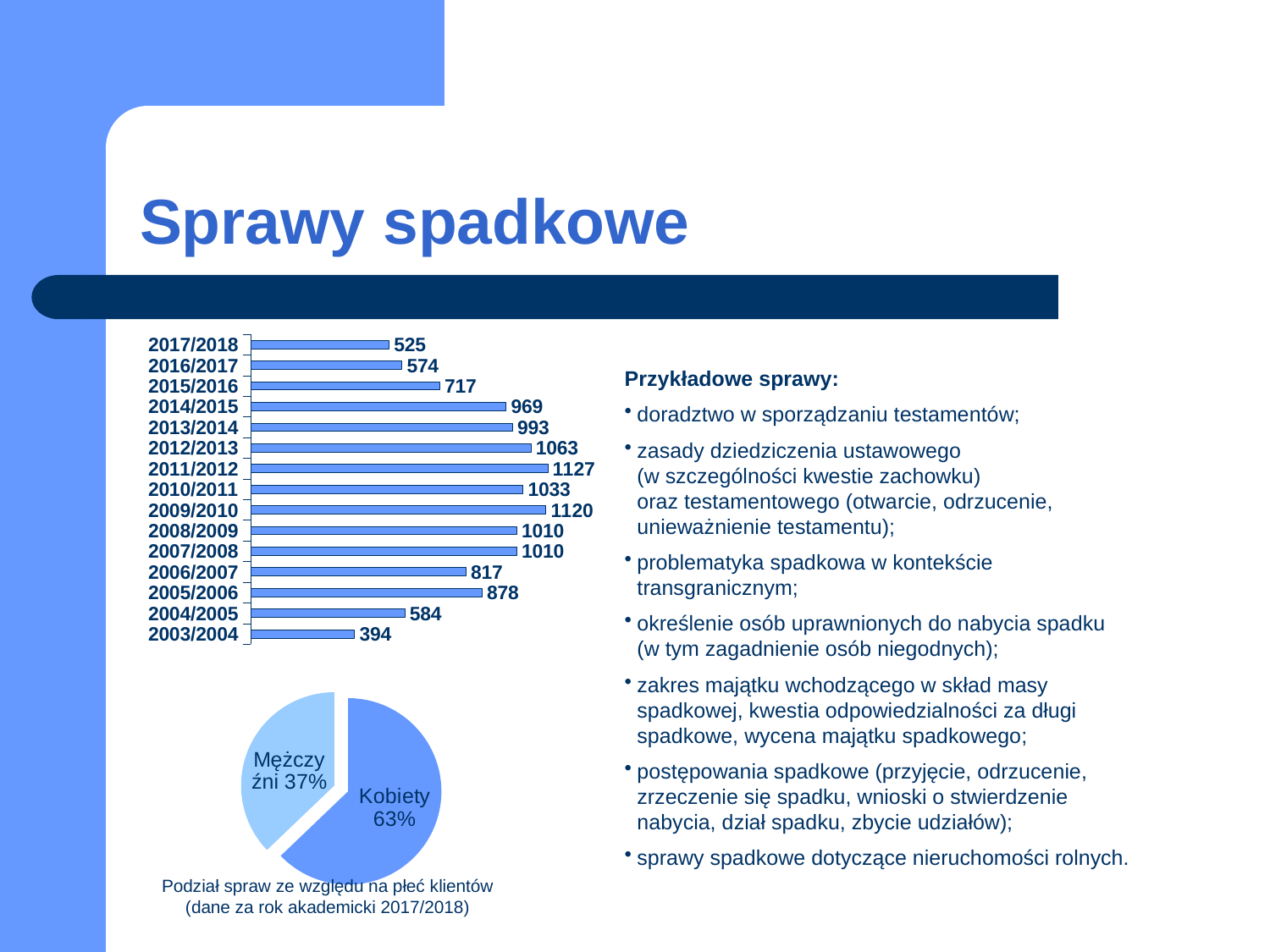
In the bar chart at the top left, which is larger, the value for 2005/2006 or the value for 2006/2007? 2005/2006 In the bar chart at the top left, how many academic years are shown? 15 What kind of chart is the chart at the top left of the slide? Bar chart In the pie chart at the bottom left, what share of cases is for Mężczyźni? 37% In the bar chart at the top left, which academic year has the lowest value? 2003/2004 In the bar chart at the top left, what is the value for 2017/2018? 525 In the bar chart at the top left, what is the value for 2003/2004? 394 In the bar chart at the top left, what is the value for 2011/2012? 1127 In the bar chart at the top left, which academic year has the highest value? 2011/2012 In the bar chart at the top left, what is the difference between the values for 2009/2010 and 2017/2018? 595 What is the caption of the pie chart at the bottom left? Podział spraw ze względu na płeć klientów (dane za rok akademicki 2017/2018) In the pie chart at the bottom left, what share of cases is for Kobiety? 63%